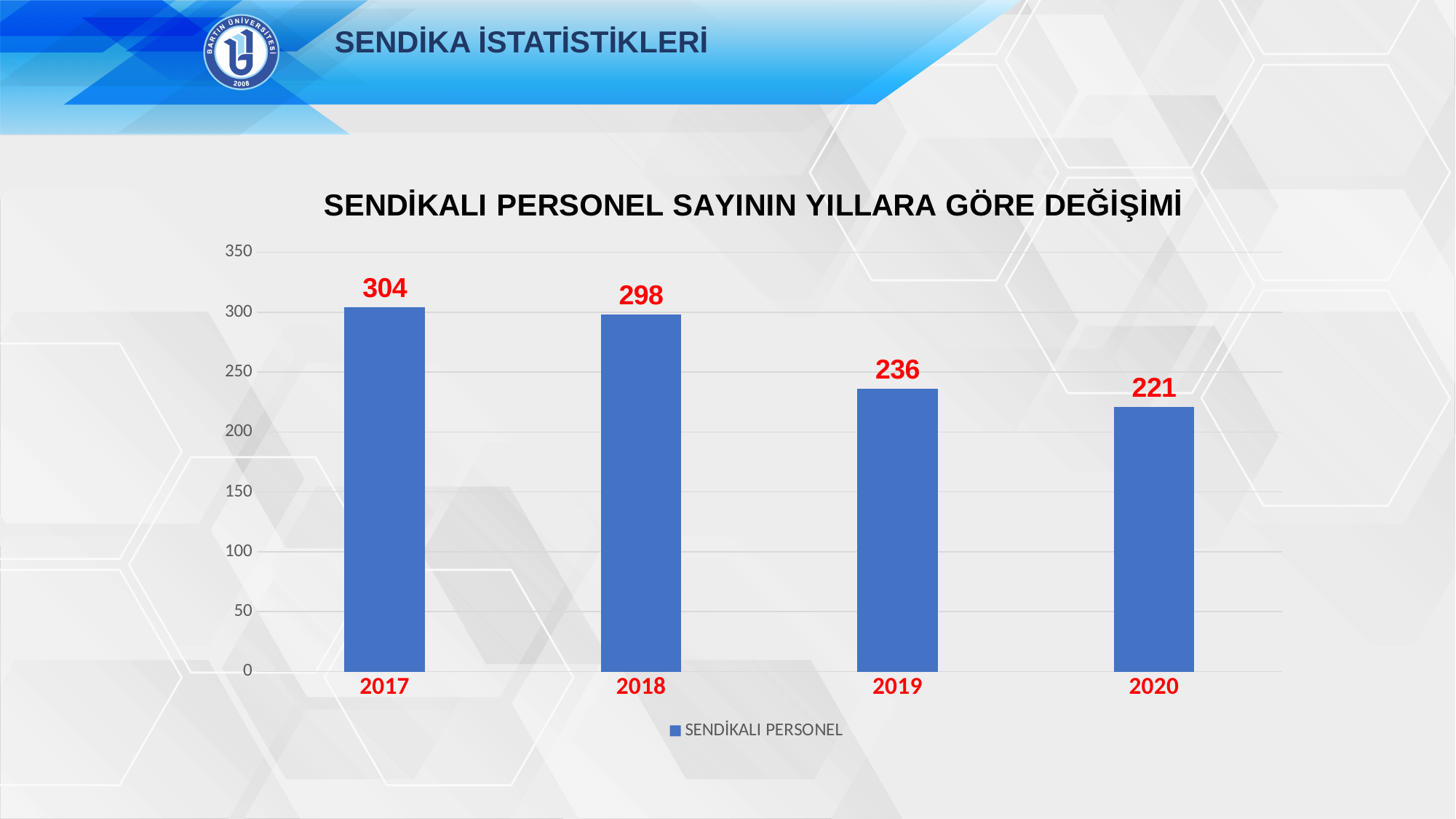
What is the value for 2017? 304 Do the values rise or fall from 2017 to 2020? fall Which is larger, the value for 2018 or the value for 2019? 2018 What is the difference between the values for 2017 and 2020? 83 What is the value for 2020? 221 Is the value for 2018 greater or less than 250? greater Which year has the highest value? 2017 What is the difference between the values for 2018 and 2019? 62 What kind of chart is shown? bar chart Which year has the lowest value? 2020 How many years are shown on the x axis? 4 What is the value for 2019? 236